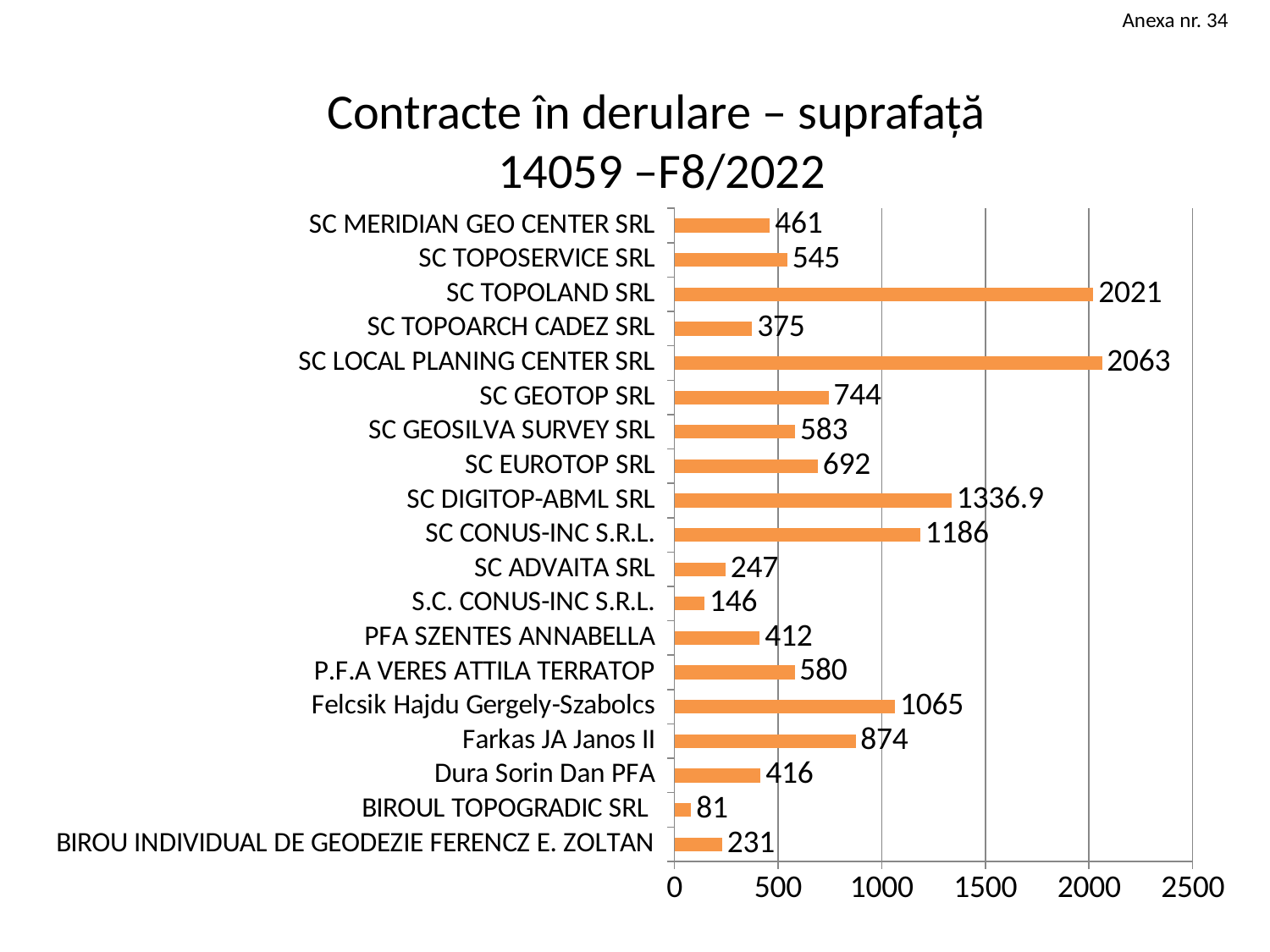
Is the value for Felcsik Hajdu Gergely-Szabolcs greater or less than 1000? greater What is the difference between the values for SC DIGITOP-ABML SRL and SC CONUS-INC S.R.L.? 150.9 What is the value for SC DIGITOP-ABML SRL? 1336.9 What is the title of the chart? Contracte în derulare – suprafață 14059 –F8/2022 What is the value for Farkas JA Janos II? 874 What kind of chart is shown on the slide? bar chart Which category has the lowest value? BIROUL TOPOGRADIC SRL Which is larger, the value for SC GEOTOP SRL or the value for SC EUROTOP SRL? SC GEOTOP SRL How many categories are shown in the chart? 19 Which category has the highest value? SC LOCAL PLANING CENTER SRL What is the value for SC TOPOLAND SRL? 2021 What is the difference between the values for SC LOCAL PLANING CENTER SRL and SC TOPOLAND SRL? 42